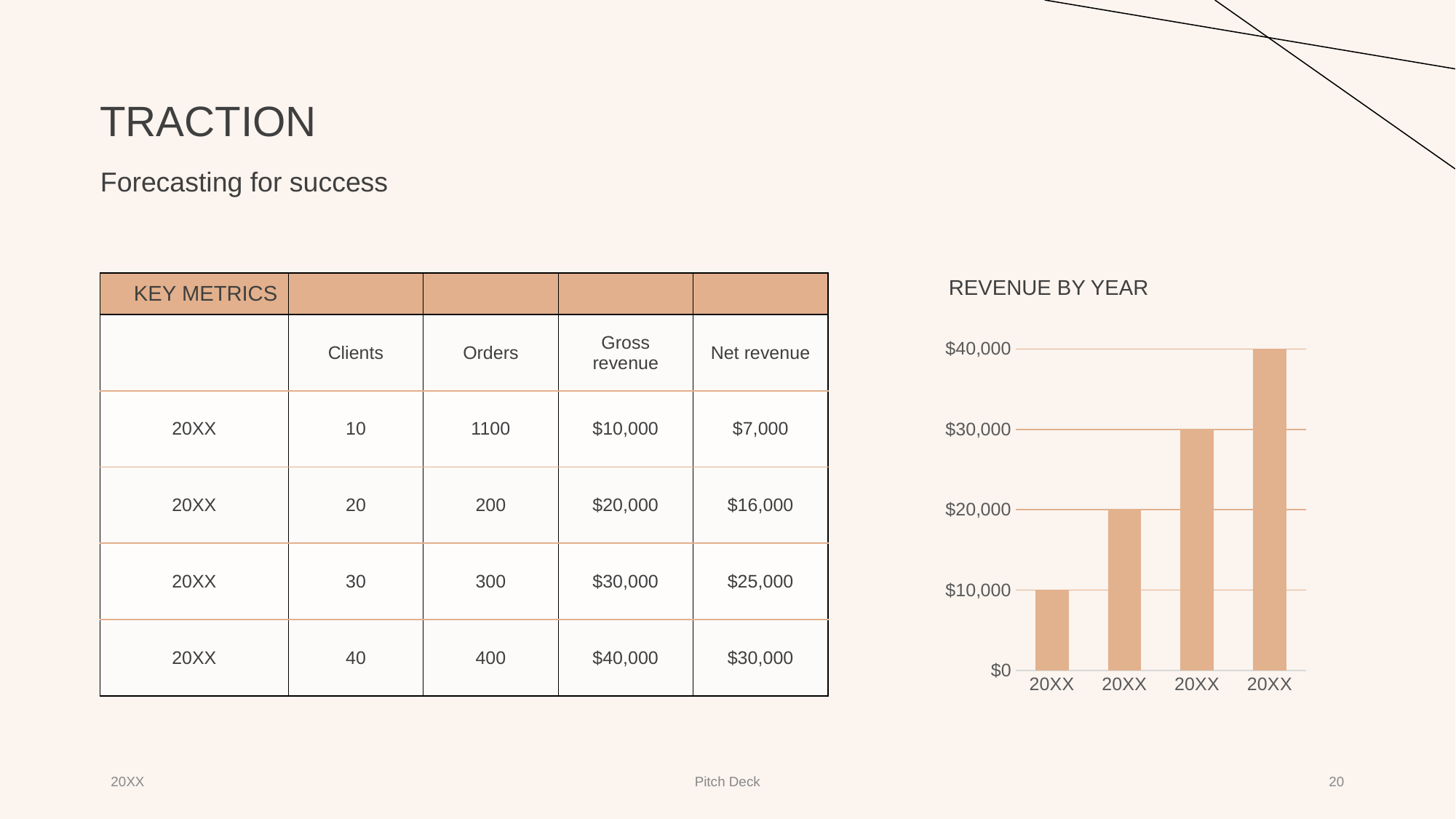
In the "REVENUE BY YEAR" chart, what is the difference between the rightmost bar and the leftmost bar? $30,000 In the "REVENUE BY YEAR" chart, is the third bar from the left taller or shorter than the second bar? Taller In the "REVENUE BY YEAR" chart, what is the value of the fourth (rightmost) bar? $40,000 In the "REVENUE BY YEAR" chart, what is the value of the third bar from the left? $30,000 In the "REVENUE BY YEAR" chart, do the bar values rise or fall from left to right? Rise In the "REVENUE BY YEAR" chart, which bar is the shortest? The first (leftmost) bar What is the highest value labelled on the vertical axis of the "REVENUE BY YEAR" chart? $40,000 In the "REVENUE BY YEAR" chart, what is the value of the first (leftmost) bar? $10,000 What kind of chart is shown under the title "REVENUE BY YEAR"? Bar chart In the "REVENUE BY YEAR" chart, which bar is the tallest? The fourth (rightmost) bar How many bars are plotted in the "REVENUE BY YEAR" chart? 4 In the "REVENUE BY YEAR" chart, what is the value of the second bar from the left? $20,000